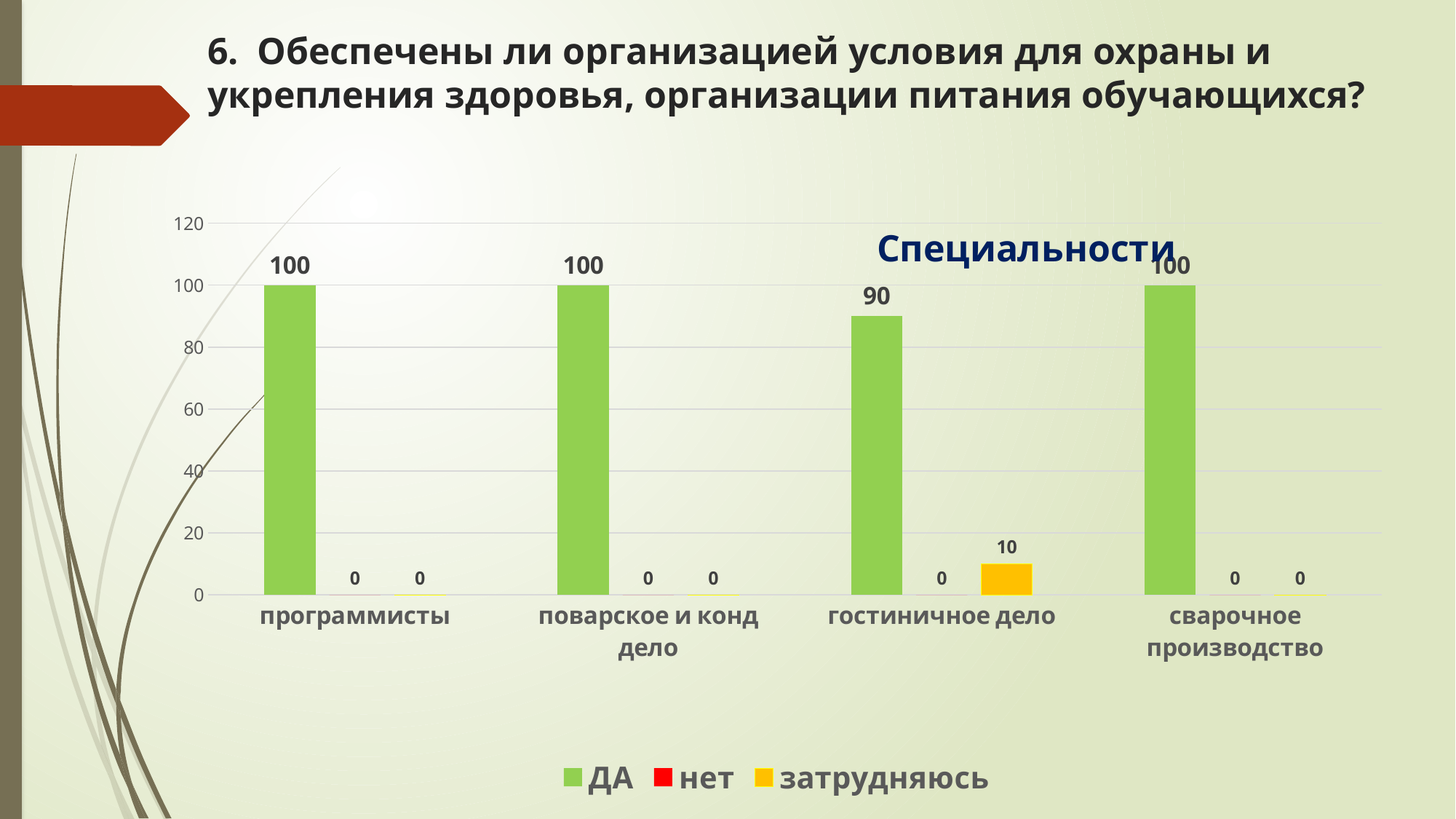
How many categories are shown on the x axis? 4 What colour represents the series ДА in the legend? green Which is larger: the ДА value for поварское и конд дело or the ДА value for гостиничное дело? поварское и конд дело What is the value of затрудняюсь for гостиничное дело? 10 What is the value of ДА for гостиничное дело? 90 What is the value of нет for сварочное производство? 0 Which category has the lowest value for ДА? гостиничное дело Which category has the highest value for затрудняюсь? гостиничное дело What is the difference between the ДА values for программисты and гостиничное дело? 10 What kind of chart is shown on the slide? bar chart How many series does the legend list? 3 What is the value of ДА for программисты? 100